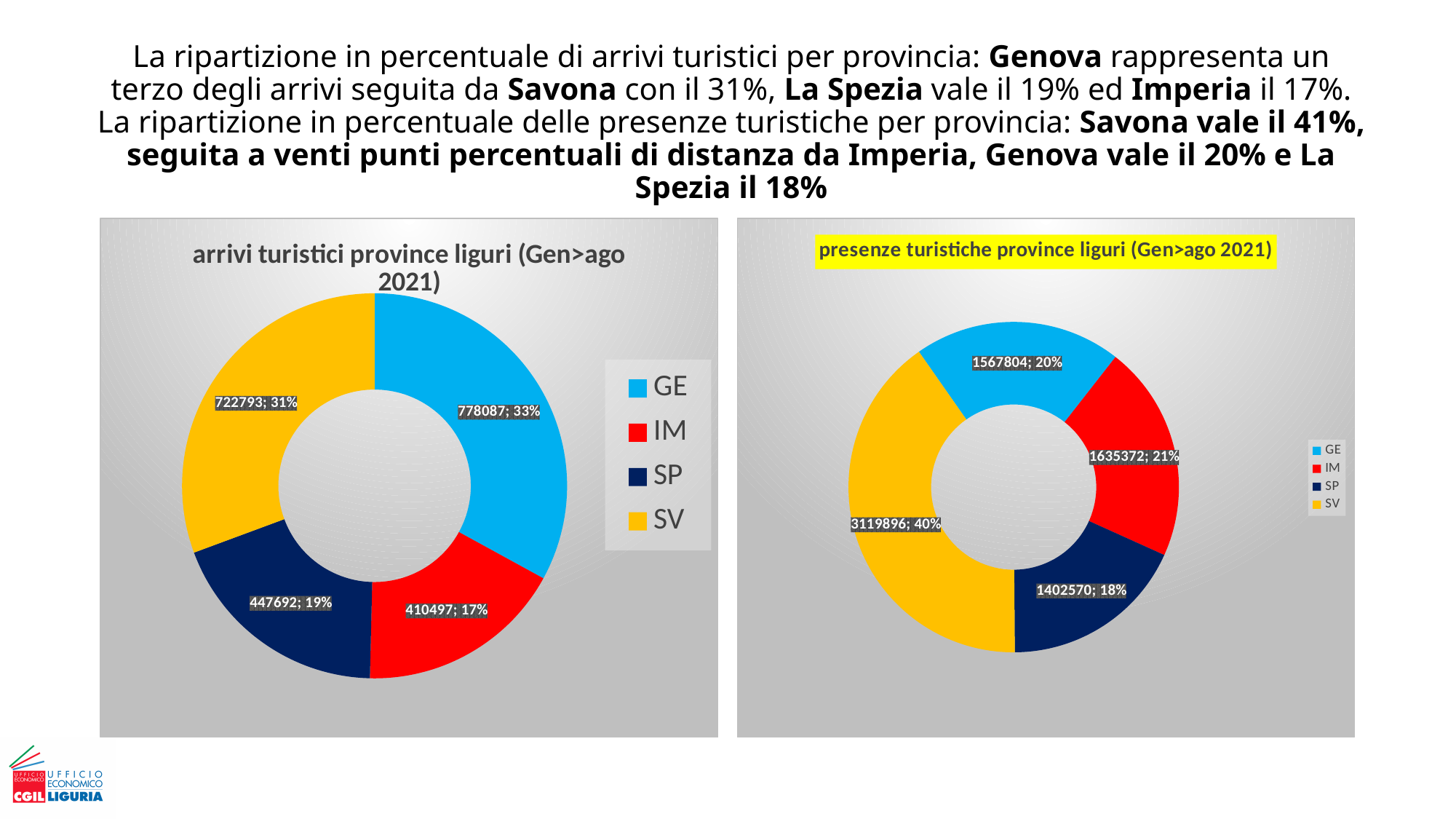
What kind of chart is the chart on the left of the slide? Doughnut (pie) chart In the chart titled 'presenze turistiche province liguri (Gen>ago 2021)', what is the value for SV? 3119896 In the chart titled 'presenze turistiche province liguri (Gen>ago 2021)', what percentage share does SP have? 18% In the chart titled 'presenze turistiche province liguri (Gen>ago 2021)', which is larger, the value for GE or the value for SP? GE In the chart titled 'presenze turistiche province liguri (Gen>ago 2021)', which province has the largest slice? SV In the chart titled 'arrivi turistici province liguri (Gen>ago 2021)', what is the value for GE? 778087 In the chart titled 'presenze turistiche province liguri (Gen>ago 2021)', what is the difference between the values for IM and GE? 67568 In the chart titled 'arrivi turistici province liguri (Gen>ago 2021)', which province has the smallest slice? IM In the chart titled 'presenze turistiche province liguri (Gen>ago 2021)', which colour represents SV in the legend? Yellow In the chart titled 'arrivi turistici province liguri (Gen>ago 2021)', what percentage share does SV have? 31% In the chart titled 'arrivi turistici province liguri (Gen>ago 2021)', what is the difference between the values for SP and IM? 37195 In the chart titled 'arrivi turistici province liguri (Gen>ago 2021)', how many slices does the doughnut have? 4